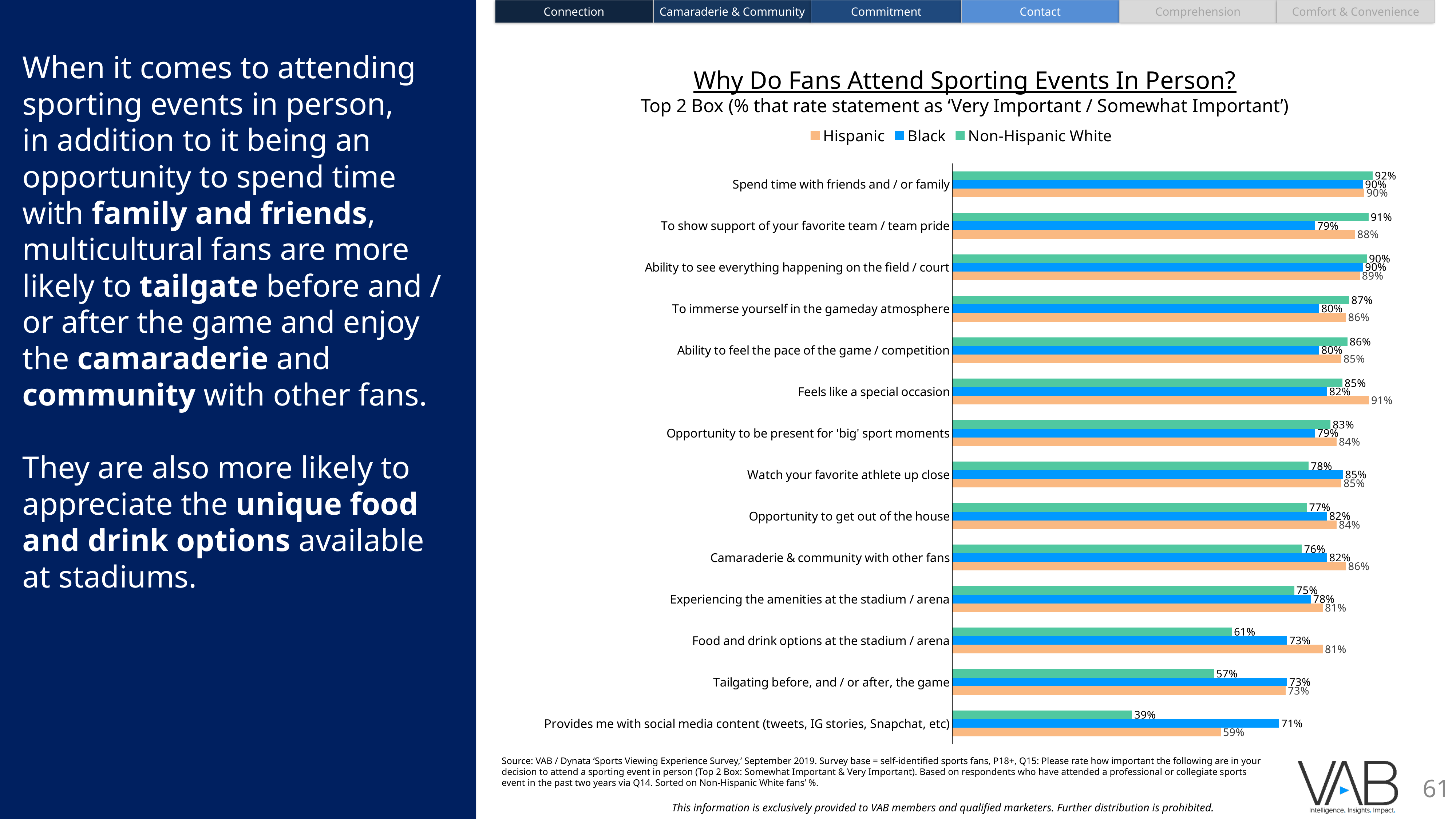
What is the difference between the Hispanic and Non-Hispanic White values for 'Food and drink options at the stadium / arena'? 20% Which reason has the lowest Non-Hispanic White value? Provides me with social media content (tweets, IG stories, Snapchat, etc) What is the difference between the Non-Hispanic White and Black values for 'To show support of your favorite team / team pride'? 12% Which series is shown in orange in the legend? Hispanic What type of chart is shown on the slide? bar chart What is the Hispanic value for 'Feels like a special occasion'? 91% How many series does the legend list? 3 What is the Black value for 'Provides me with social media content (tweets, IG stories, Snapchat, etc)'? 71% For 'Tailgating before, and / or after, the game', which is larger: the Black value or the Non-Hispanic White value? Black How many reasons (categories) are plotted in the chart? 14 Which reason has the highest Non-Hispanic White value? Spend time with friends and / or family What percentage of Non-Hispanic White fans rate 'Spend time with friends and / or family' as important? 92%